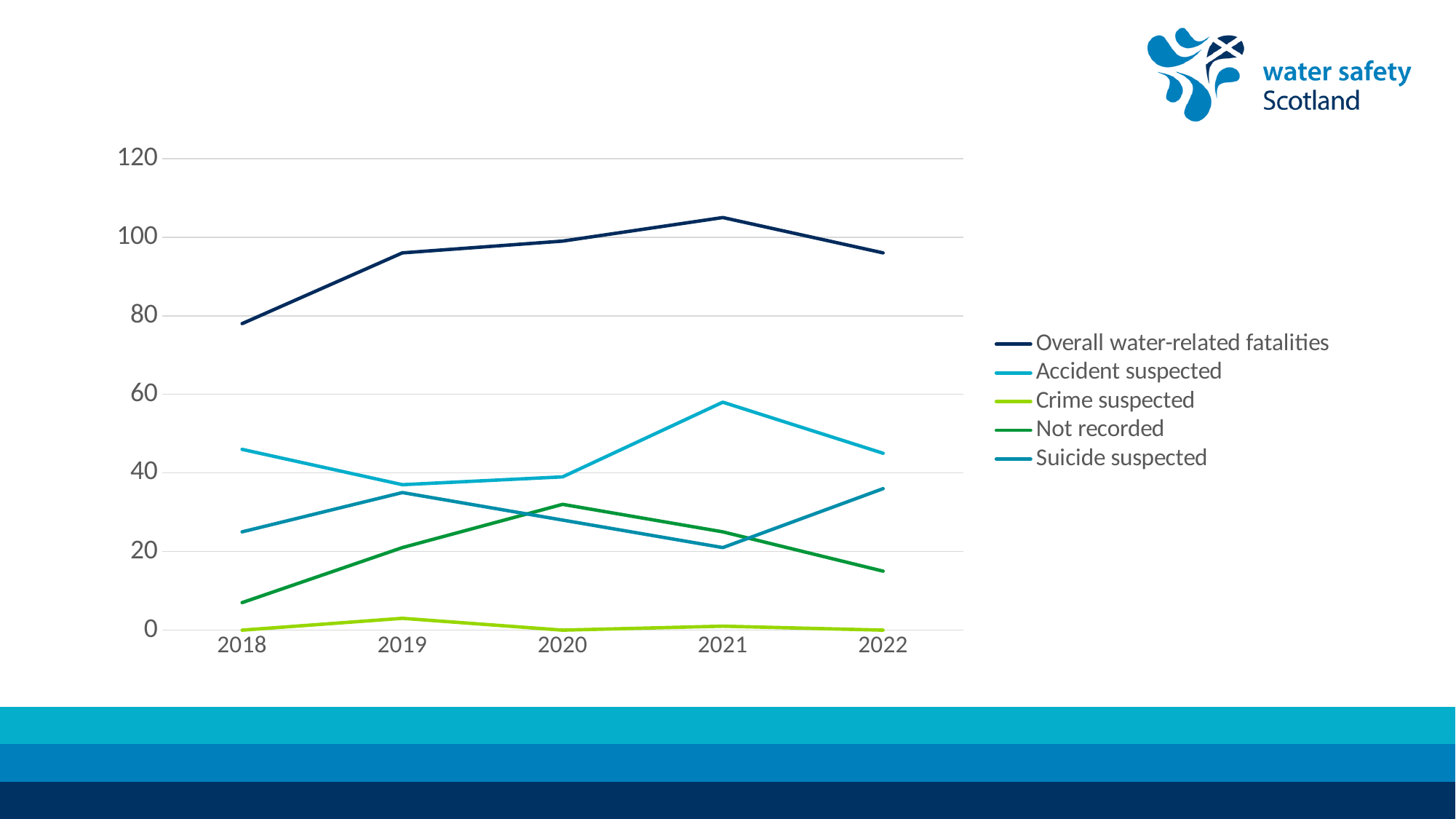
Is the value for Suicide suspected in 2018 greater or less than 40? less In which year is the value for Overall water-related fatalities lowest? 2018 In which year is the value for Overall water-related fatalities highest? 2021 Which series has the lowest values across all years shown? Crime suspected In 2022, which is larger: Suicide suspected or Not recorded? Suicide suspected Is the value for Accident suspected in 2021 greater or less than 40? greater How many series does the legend list? 5 What kind of chart is shown on the slide? line chart Is the value for Overall water-related fatalities in 2021 greater or less than 100? greater In which year is the value for Accident suspected highest? 2021 How many years are shown on the x axis? 5 Does the value for Not recorded rise or fall from 2018 to 2020? rise